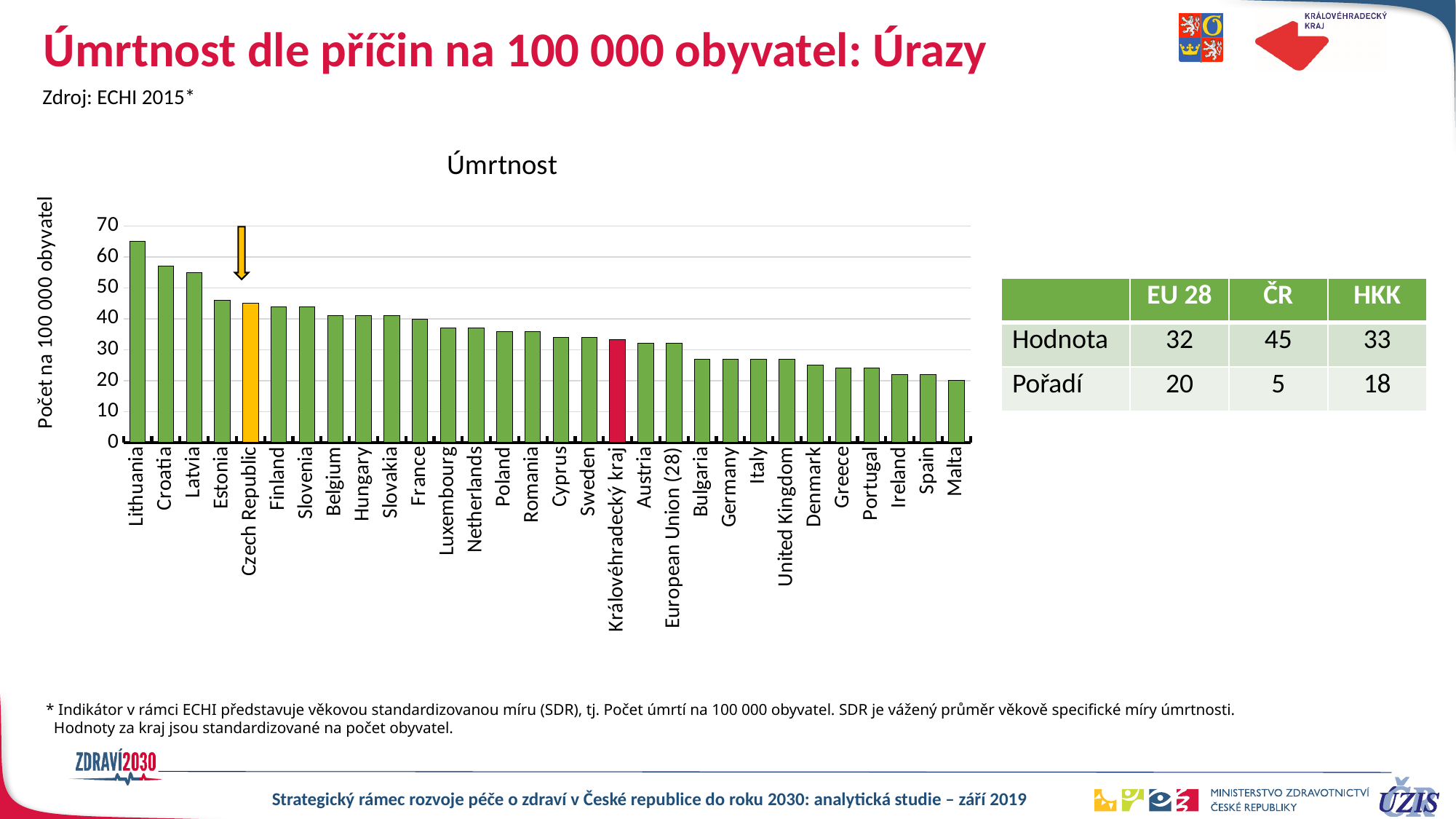
How many categories (bars) are plotted in the chart? 30 Is the value for Lithuania greater or less than 60? greater What is the title of the chart? Úmrtnost What kind of chart is shown on the slide? bar chart According to the table on the slide, what is the value (Hodnota) for ČR? 45 Is the value for Malta greater or less than 30? less Is the value for Croatia greater or less than 50? greater Do the values rise or fall moving from left to right along the x axis? fall Which is larger, the value for Czech Republic or the value for Královéhradecký kraj? Czech Republic Which category has the highest value in the chart? Lithuania Which category has the lowest value in the chart? Malta According to the table on the slide, what is the difference between the value for ČR and the value for HKK? 12